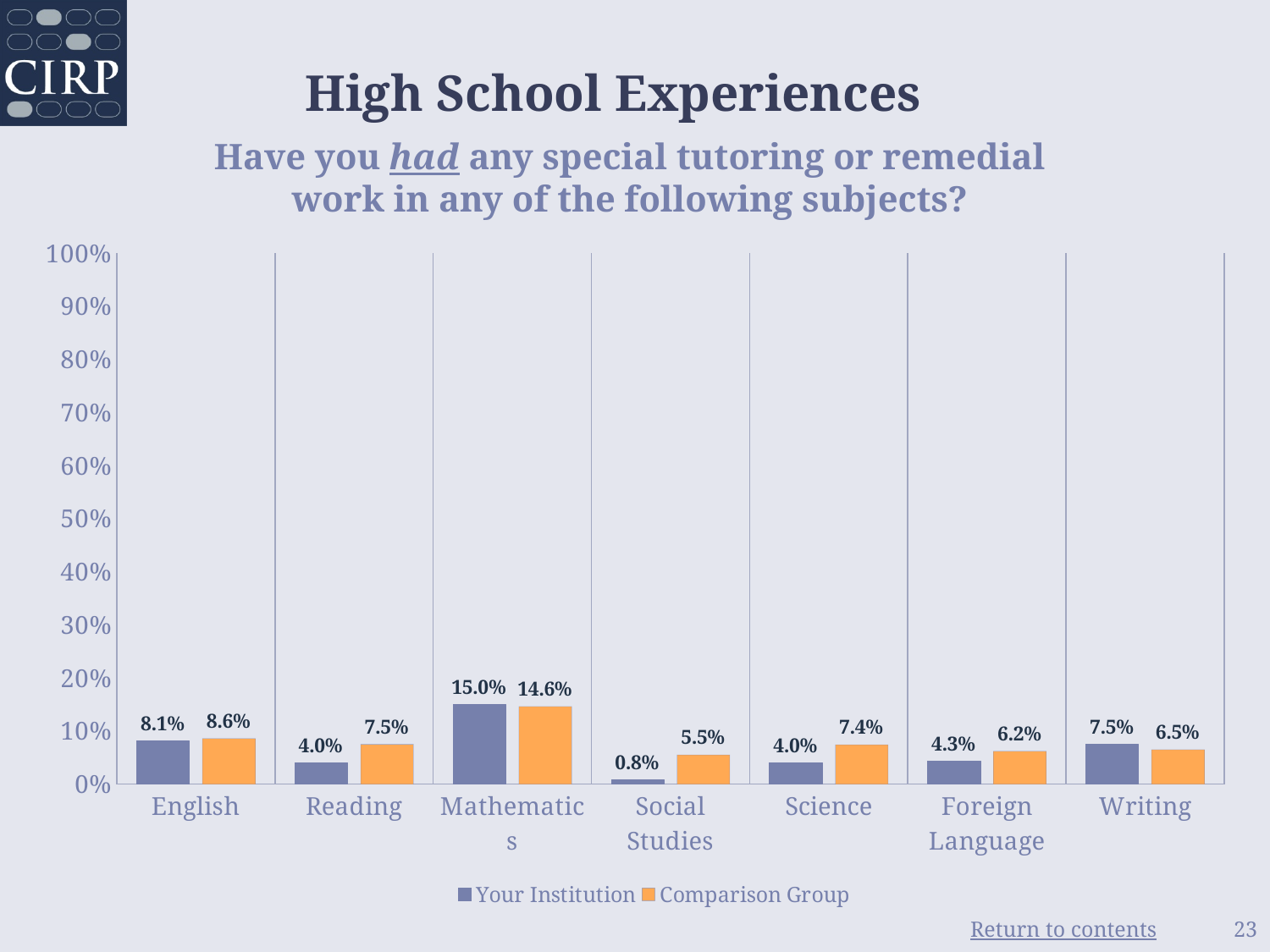
Is the value for Your Institution in Mathematics greater or less than 10%? greater Which is larger for Science: Your Institution or Comparison Group? Comparison Group What kind of chart is shown on the slide? Bar chart Which subject has the lowest value for Your Institution? Social Studies How many subjects are shown on the x axis? 7 Which subject has the highest value for Your Institution? Mathematics Which subject has the lowest value for Comparison Group? Social Studies What is the value for Your Institution in Mathematics? 15.0% What is the value for Your Institution in Foreign Language? 4.3% What is the difference between the Comparison Group and Your Institution values for Reading? 3.5% What is the value for Comparison Group in Social Studies? 5.5% How many series does the legend list? 2